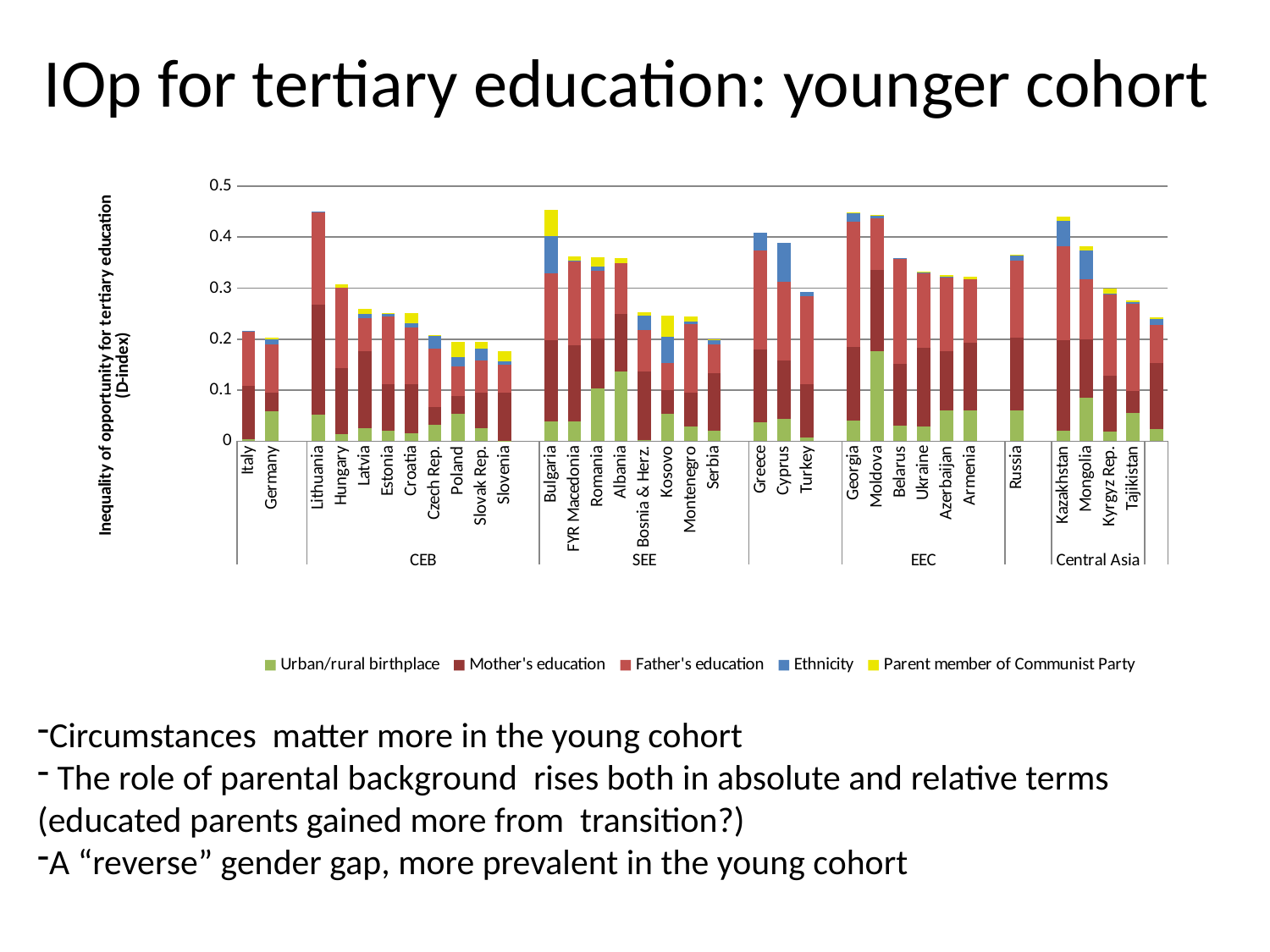
Is the total value for Belarus greater or less than 0.3? greater How many countries are shown in the SEE group? 8 Which country in the SEE group has the lowest total inequality of opportunity? Serbia What is the label on the vertical axis of the chart? Inequality of opportunity for tertiary education (D-index) How many series does the legend list? 5 Which country in the SEE group has the highest total inequality of opportunity? Bulgaria What kind of chart is shown on the slide? Stacked bar chart How many countries are shown in the CEB group? 9 Is the total value for Lithuania greater or less than 0.4? greater Which has the larger total bar, Greece or Turkey? Greece Which country in the Central Asia group has the highest total bar? Kazakhstan